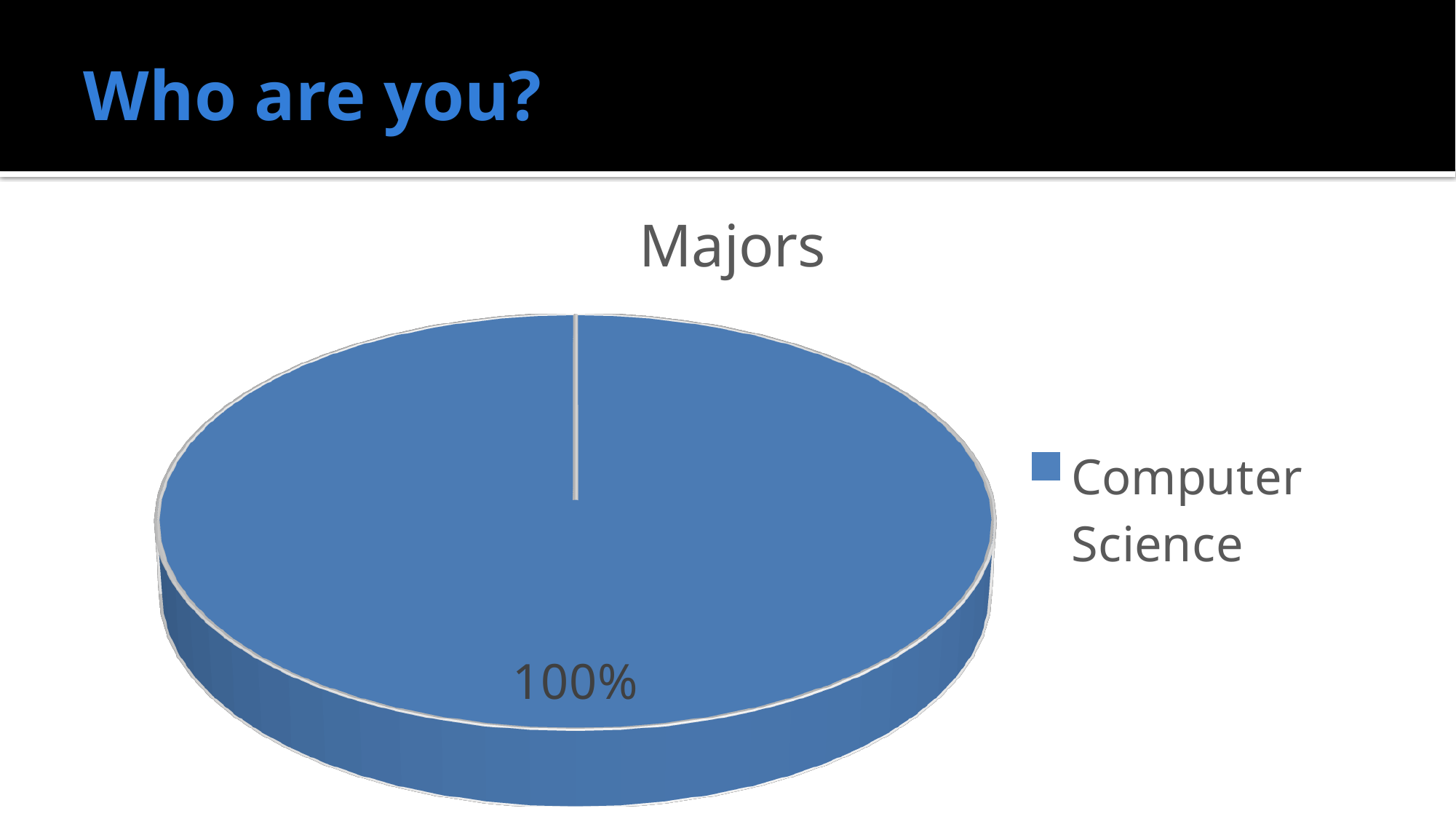
Which category is shown in the legend? Computer Science What share of the pie does Computer Science have? 100% What is the data label printed on the pie slice? 100% What kind of chart is shown on the slide? pie chart How many entries does the legend list? 1 How many slices does the pie chart have? 1 What is the title of the chart? Majors Which category has the largest share of the pie? Computer Science